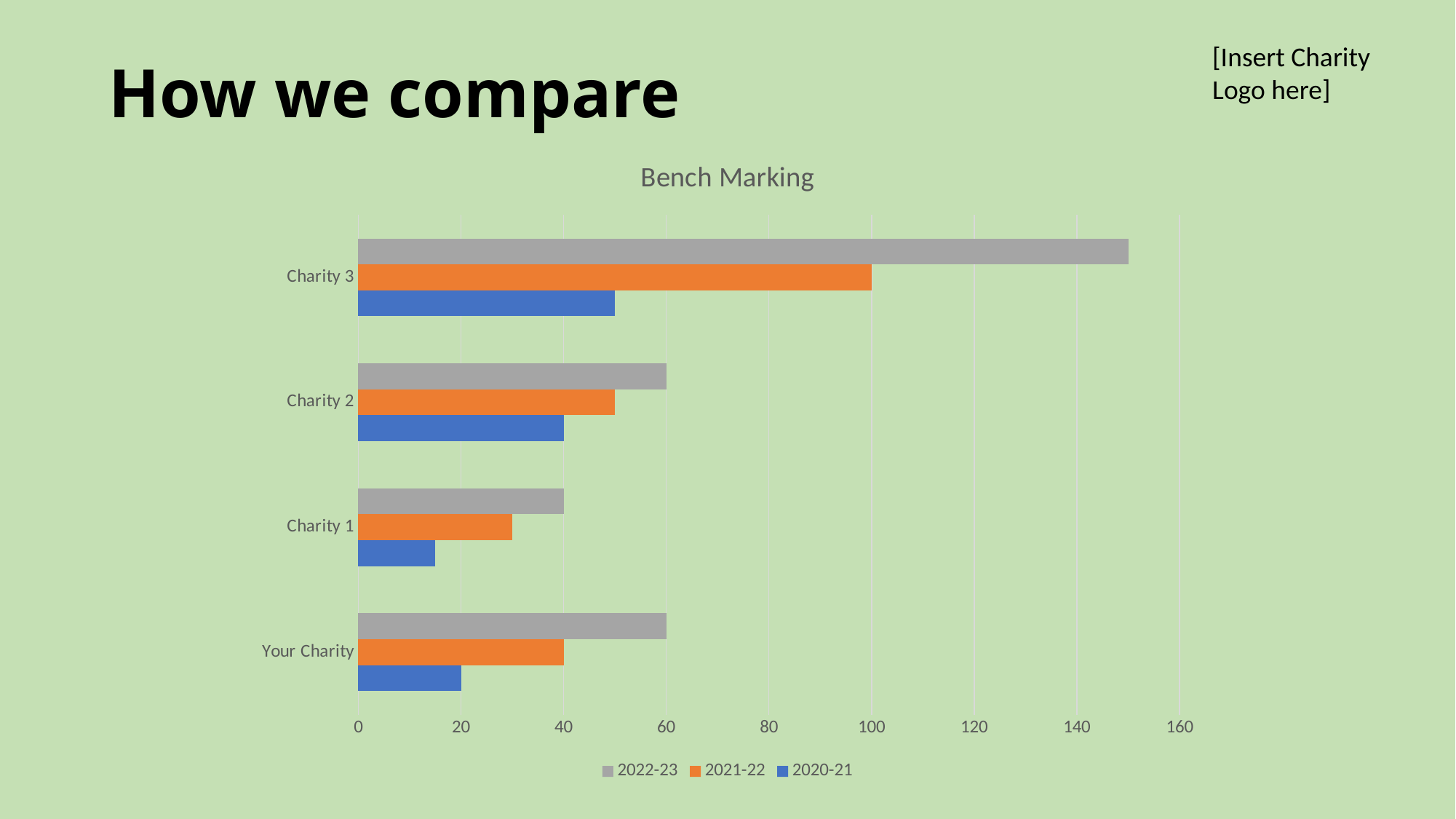
How many charities are shown on the chart? 4 Which is larger, the 2021-22 value for Charity 3 or the 2021-22 value for Charity 2? Charity 3 What is the 2021-22 value for Charity 3? 100 How many series does the legend list? 3 Which charity has the lowest 2022-23 value? Charity 1 What is the difference between the 2022-23 and 2020-21 values for Your Charity? 40 What is the 2022-23 value for Your Charity? 60 Which charity has the highest 2022-23 value? Charity 3 What is the 2022-23 value for Charity 1? 40 What is the 2020-21 value for Your Charity? 20 Is the 2022-23 value for Charity 3 greater or less than 140? greater Is the 2020-21 value for Charity 1 greater or less than 20? less